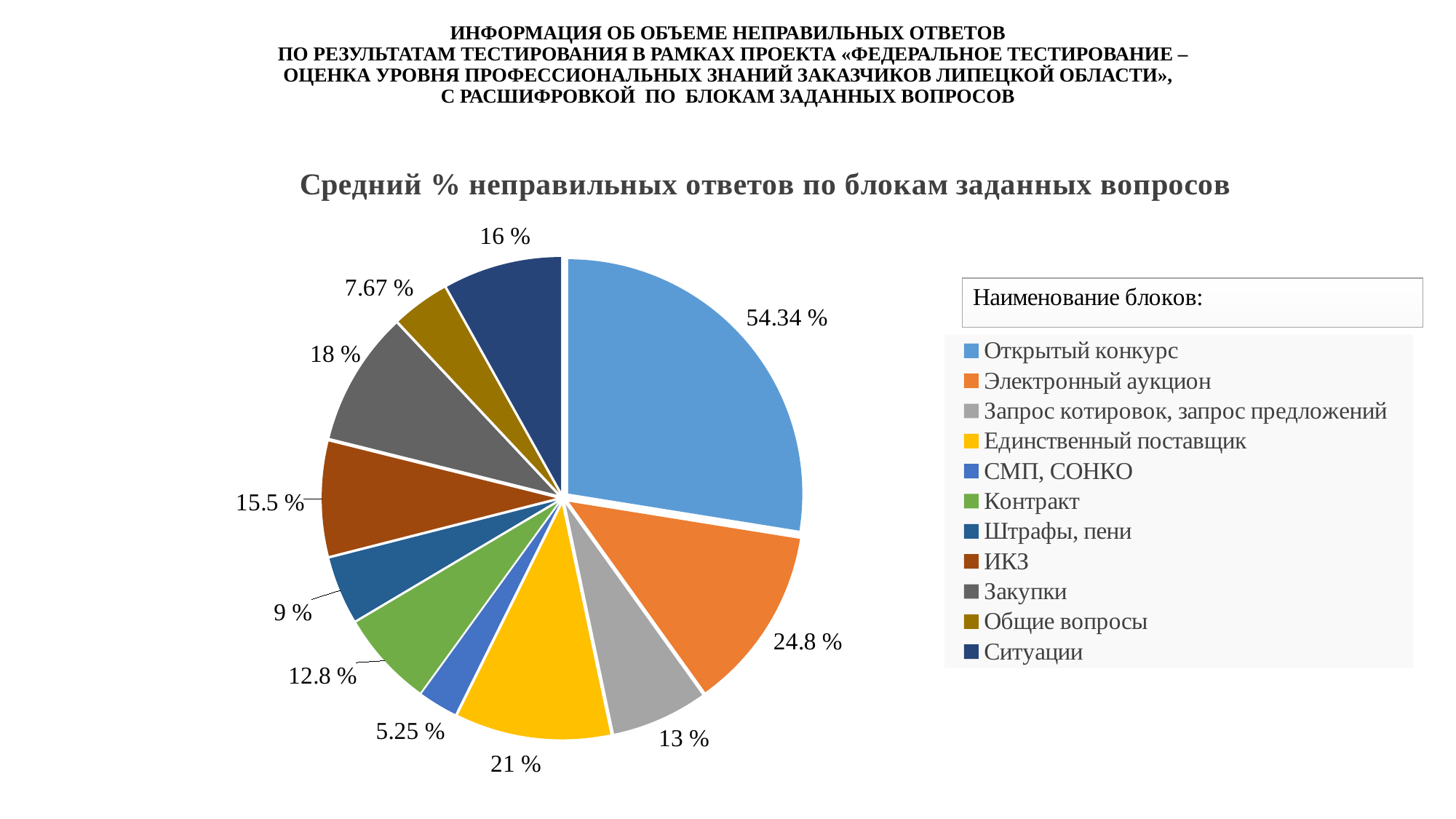
What is the value shown for Электронный аукцион? 24.8 % Which block has the highest value in the pie chart? Открытый конкурс What kind of chart is shown on the slide? pie chart Which block has the lowest value in the pie chart? СМП, СОНКО How many blocks (slices) are shown in the pie chart? 11 What is the value shown for Общие вопросы? 7.67 % What is the value shown for Единственный поставщик? 21 % What is the title of the pie chart? Средний % неправильных ответов по блокам заданных вопросов What is the difference between the values for Открытый конкурс and Электронный аукцион? 29.54 % Which is larger, the value for Закупки or the value for Ситуации? Закупки What is the value shown for Открытый конкурс? 54.34 % What is the value shown for СМП, СОНКО? 5.25 %